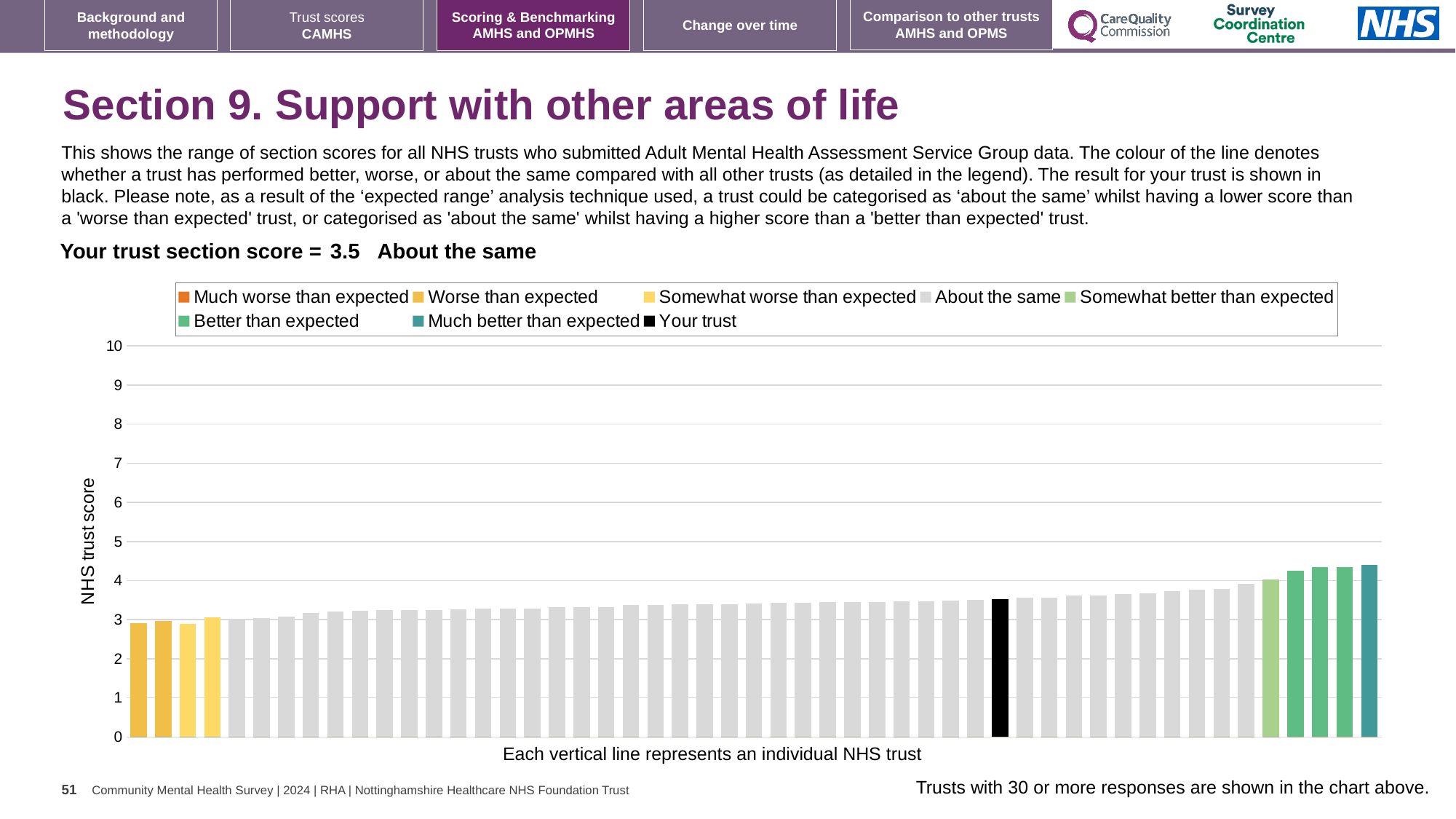
Do the bar values rise or fall from left to right across the chart? rise What kind of chart is shown on the slide? bar chart Which performance category is your trust placed in for this section? About the same Which legend category does the tallest bar belong to? Much better than expected Is the value of the black 'Your trust' bar greater or less than 3? greater How many entries does the chart legend list? 8 Is the value of the leftmost bar greater or less than 4? less What is the label on the vertical axis of the chart? NHS trust score What is the section score for your trust? 3.5 Is the value of the tallest bar greater or less than 5? less Which is taller, the black 'Your trust' bar or the leftmost bar? the black 'Your trust' bar